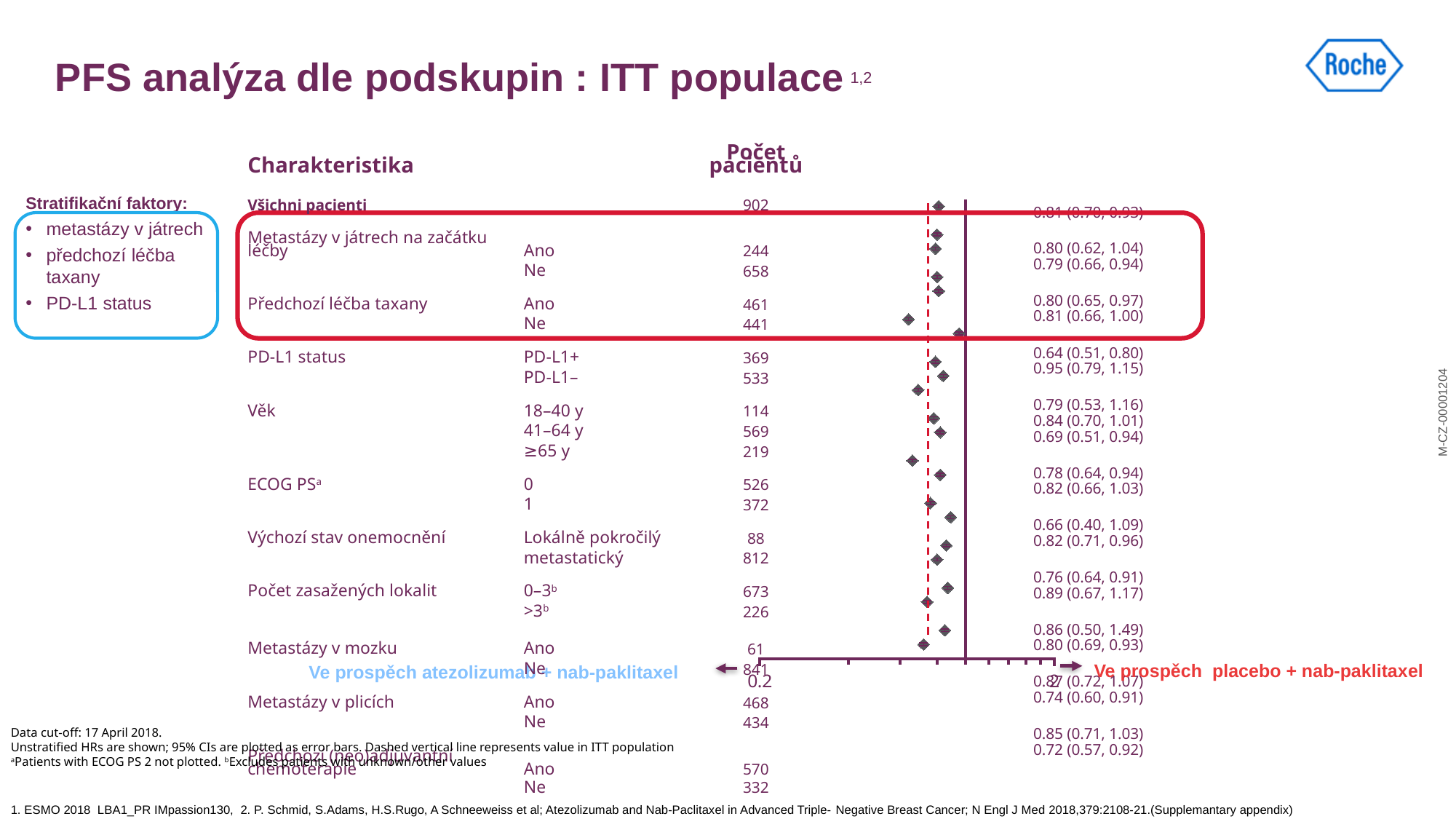
What is the lowest value printed on the horizontal axis of the forest plot? 0.2 How many patients are in the 'Metastázy v mozku – Ano' subgroup? 61 What kind of chart is shown on the slide? Forest plot How many patients are in the 'Všichni pacienti' (all patients) row? 902 How many patients had liver metastases at baseline (Metastázy v játrech na začátku léčby – Ano)? 244 Which has more patients: the 'Předchozí léčba taxany – Ano' subgroup or the 'Předchozí léčba taxany – Ne' subgroup? Ano (461) How many patients are in the PD-L1+ subgroup? 369 What is the hazard ratio (95% CI) shown for the PD-L1+ subgroup? 0.64 (0.51, 0.80) What is the difference in patient numbers between the PD-L1– (533) and PD-L1+ (369) subgroups? 164 What is the hazard ratio (95% CI) shown for the PD-L1– subgroup? 0.95 (0.79, 1.15) Which age subgroup (Věk) has the fewest patients? 18–40 y (114) According to the footnote, what does the dashed vertical line represent? Value in ITT population